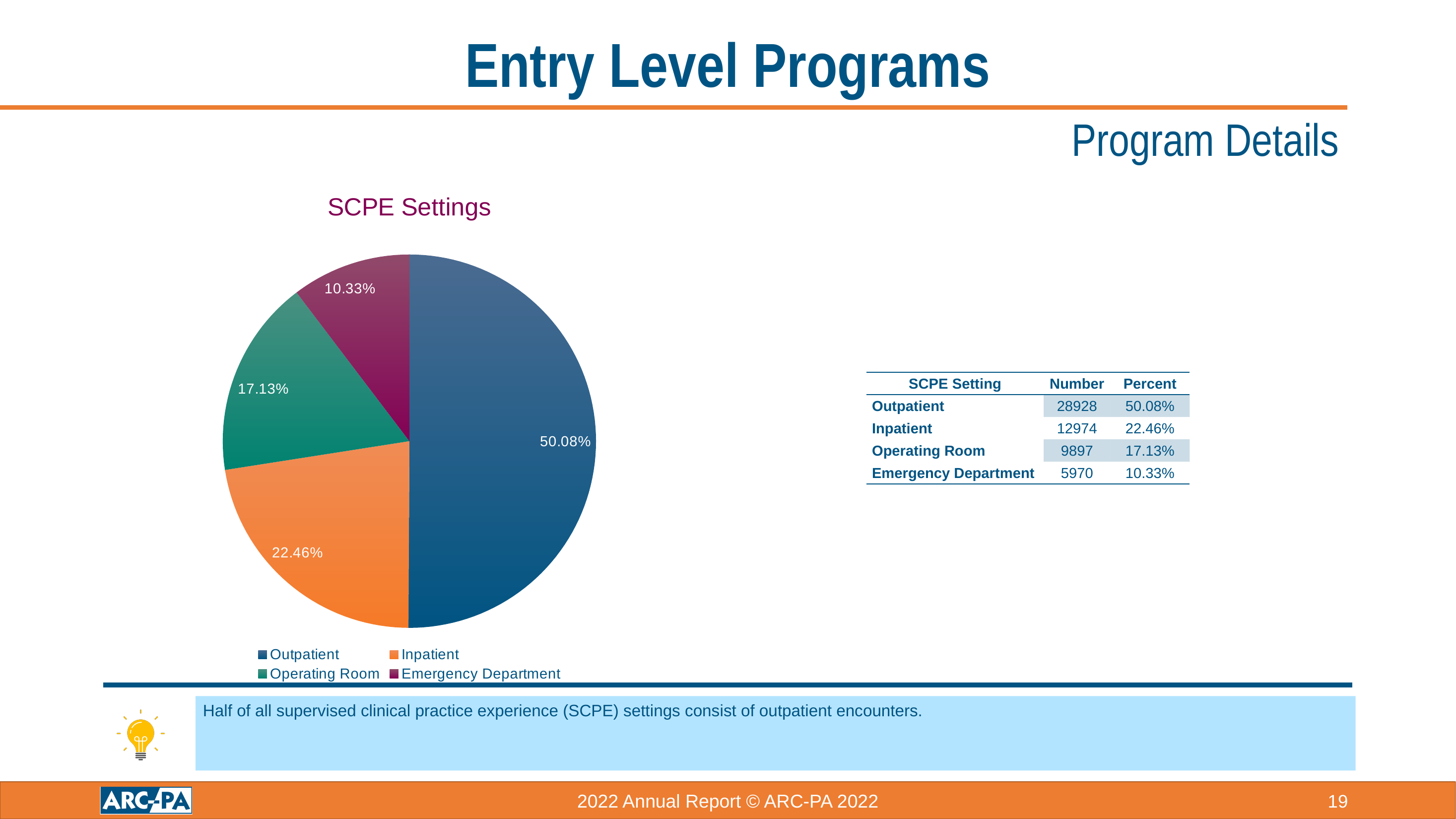
Which slice is larger, Operating Room or Emergency Department? Operating Room Which SCPE setting has the largest slice of the pie? Outpatient What is the difference in percentage points between the Inpatient and Operating Room slices? 5.33 What share of the pie does Operating Room represent? 17.13% What share of the pie does Inpatient represent? 22.46% What kind of chart is shown on the slide? pie chart What is the title of the chart? SCPE Settings Which SCPE setting has the smallest slice of the pie? Emergency Department What share of the pie does Emergency Department represent? 10.33% How many slices does the pie chart have? 4 Which colour represents Inpatient in the pie chart? orange